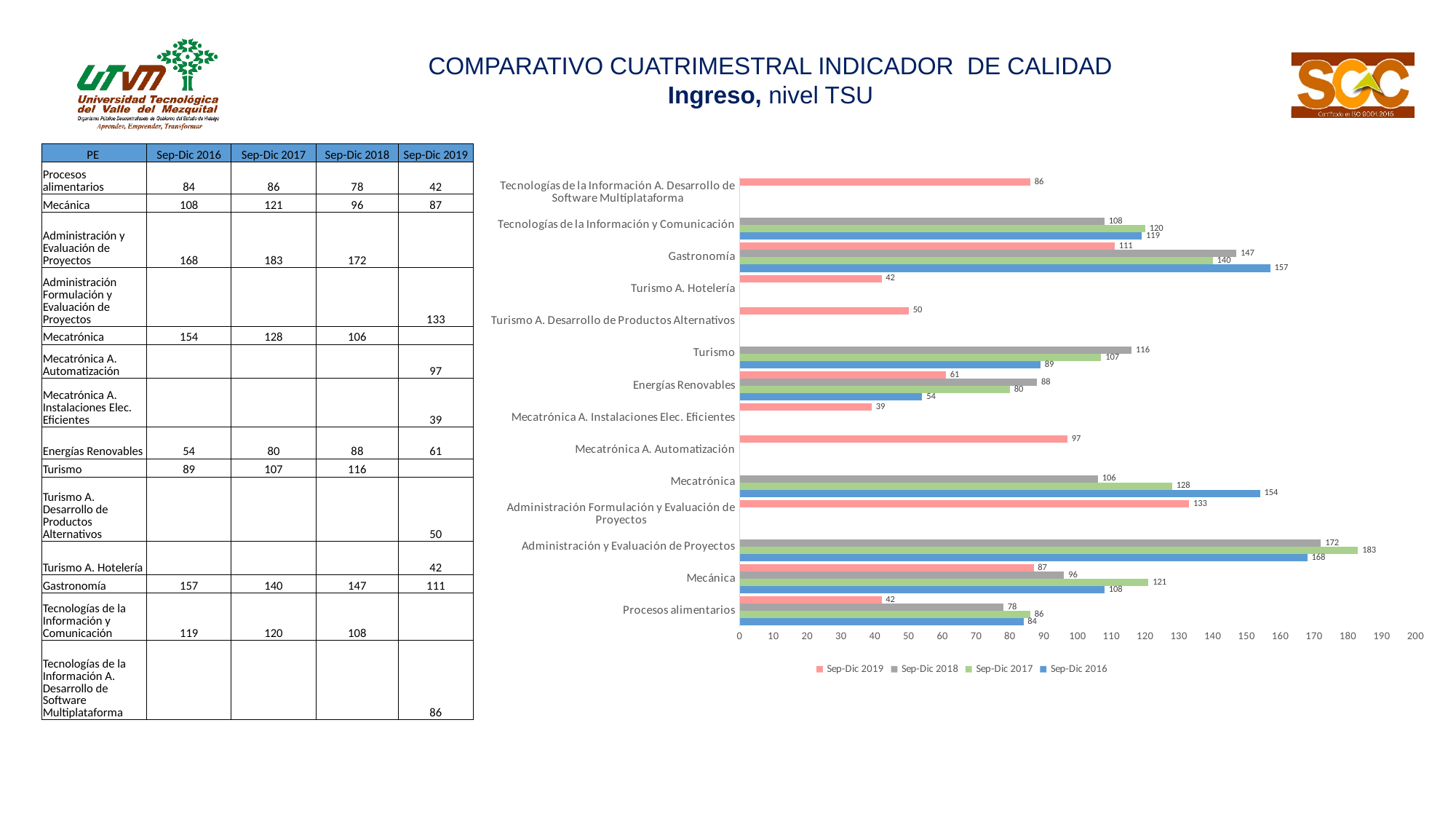
Which is larger for Energías Renovables: the Sep-Dic 2018 value or the Sep-Dic 2016 value? Sep-Dic 2018 What is the difference between the Sep-Dic 2016 and Sep-Dic 2018 values for Mecatrónica? 48 How many categories are shown on the chart's vertical axis? 14 Which category has the lowest Sep-Dic 2019 value? Mecatrónica A. Instalaciones Elec. Eficientes What is the Sep-Dic 2019 value for Mecatrónica A. Automatización? 97 Which category has the highest Sep-Dic 2017 value? Administración y Evaluación de Proyectos What kind of chart is shown on the slide? bar chart Which series is shown in blue in the chart legend? Sep-Dic 2016 Is the Sep-Dic 2019 value for Administración Formulación y Evaluación de Proyectos greater or less than 120? greater What is the Sep-Dic 2016 value for Gastronomía? 157 What is the Sep-Dic 2017 value for Mecánica? 121 How many series does the chart legend list? 4